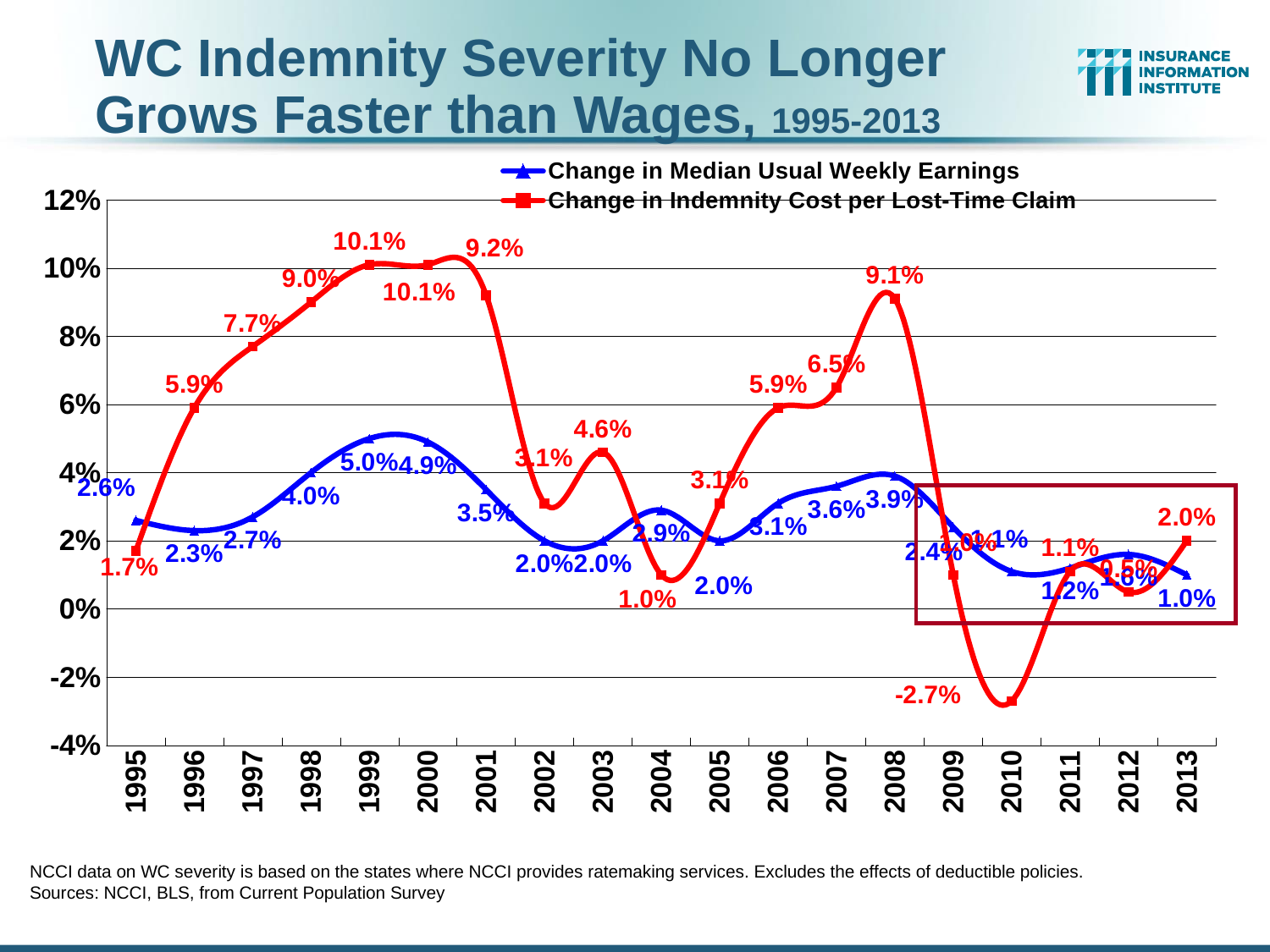
How many series does the legend list? 2 How many years are plotted on the x axis? 19 In which year was the Change in Indemnity Cost per Lost-Time Claim lowest? 2010 What kind of chart is shown on the slide? Line chart Is the Change in Indemnity Cost per Lost-Time Claim in 1997 greater or less than 6%? greater In 2008, how much higher was the Change in Indemnity Cost per Lost-Time Claim (9.1%) than the Change in Median Usual Weekly Earnings (3.9%)? 5.2 percentage points In which year was the Change in Median Usual Weekly Earnings highest? 1999 Did the Change in Indemnity Cost per Lost-Time Claim rise or fall from 1995 to 1999? Rise In 2004, which was larger: the Change in Median Usual Weekly Earnings or the Change in Indemnity Cost per Lost-Time Claim? Change in Median Usual Weekly Earnings What was the Change in Median Usual Weekly Earnings in 1998? 4.0% What was the Change in Indemnity Cost per Lost-Time Claim in 2010? -2.7% What was the Change in Indemnity Cost per Lost-Time Claim in 1999? 10.1%